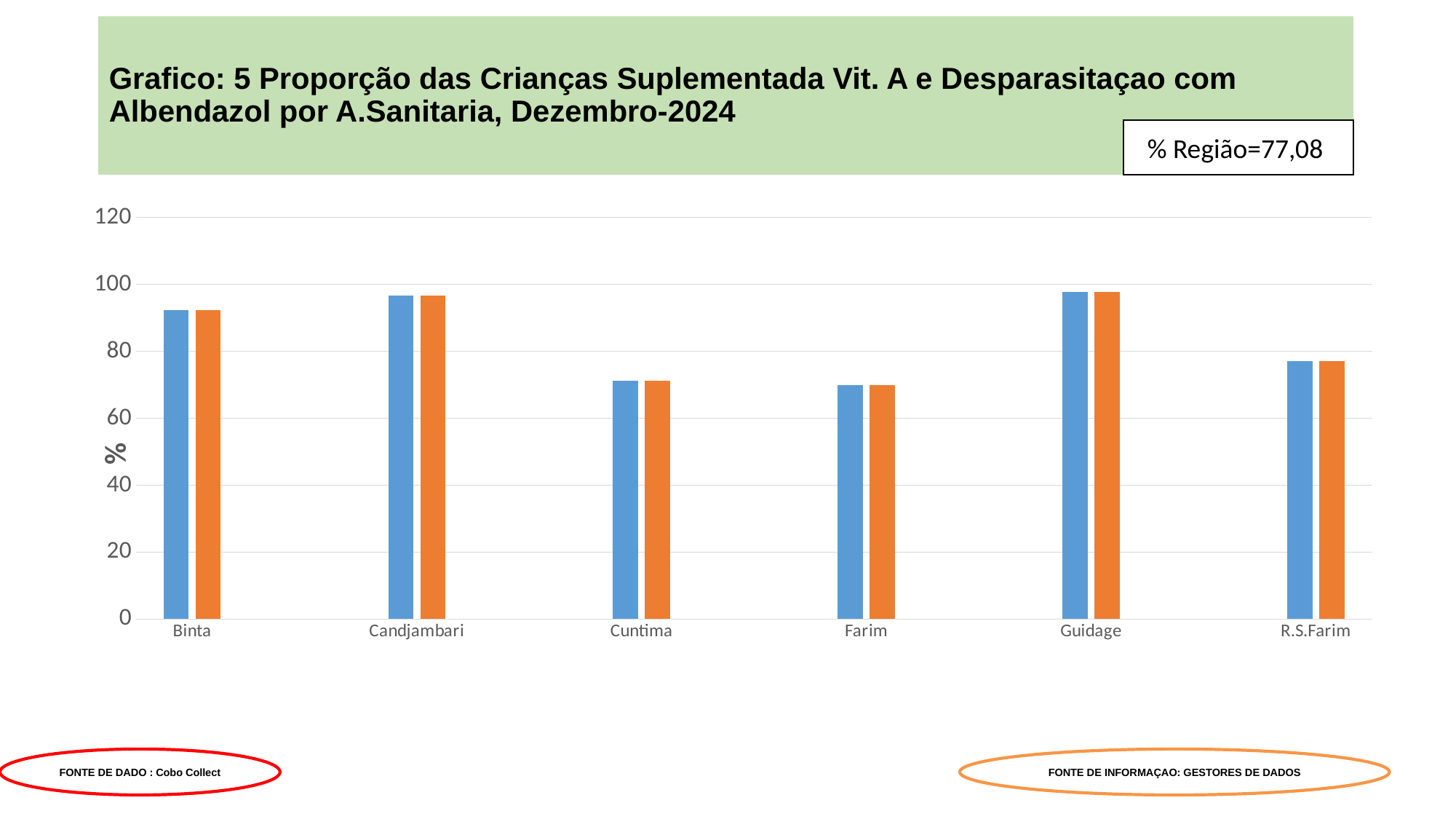
Is the value for Guidage greater or less than 80? greater Which has a higher value, Binta or Cuntima? Binta What is the label on the vertical axis of the chart? % Is the value for Binta greater or less than 80? greater What kind of chart is shown on the slide? bar chart Is the value for Farim greater or less than 60? greater How many health areas (categories) are shown on the x axis of the chart? 6 Which has a higher value, R.S.Farim or Candjambari? Candjambari What regional percentage (% Região) is shown in the box on the slide? 77,08 Which has a higher value, Farim or Guidage? Guidage